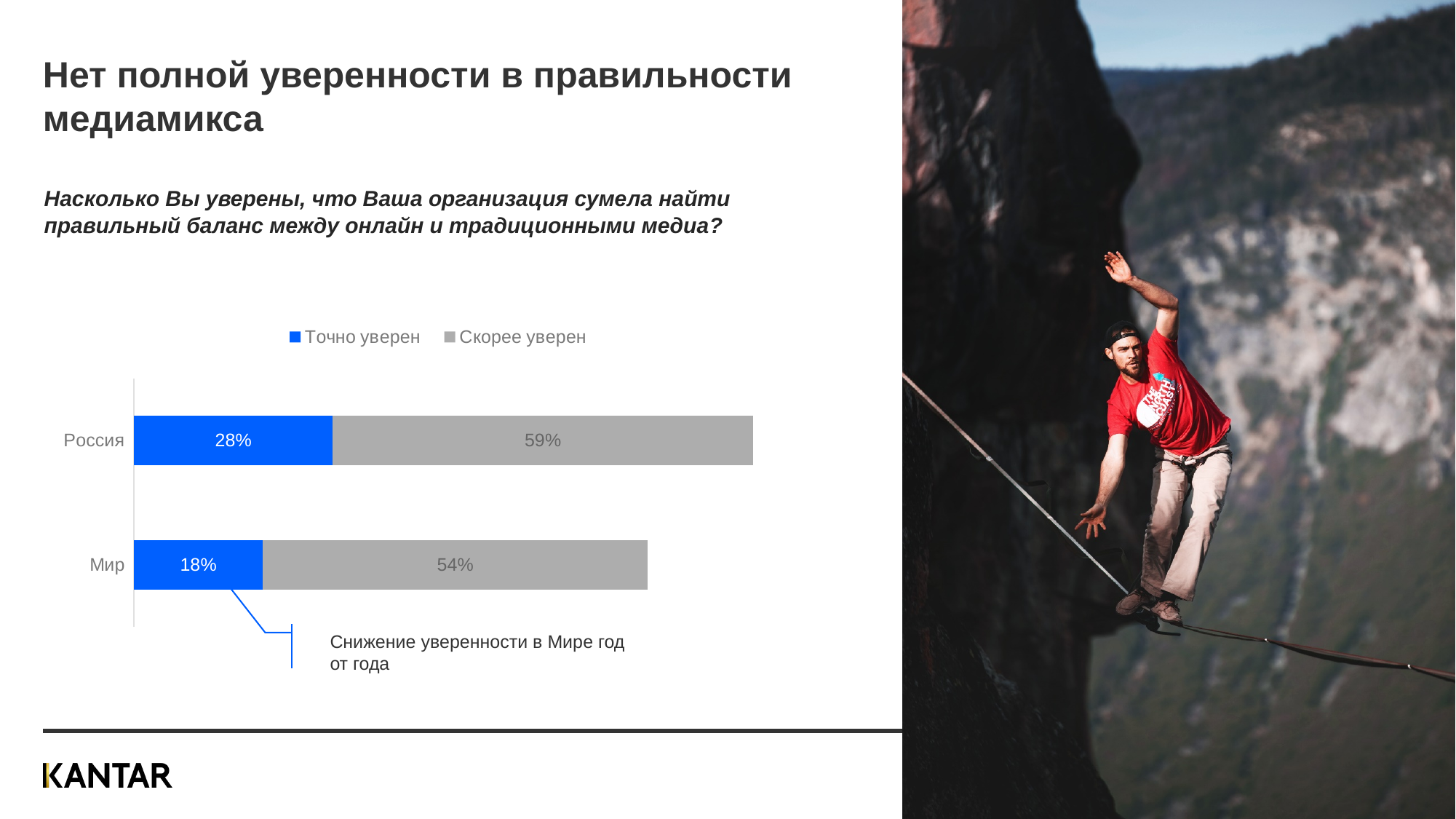
What is the difference between the "Скорее уверен" values for Россия and Мир? 5% What is the total of the stacked bar for Россия? 87% Which category has the higher "Точно уверен" value, Россия or Мир? Россия What type of chart is shown on the slide? Stacked bar chart What is the value of "Скорее уверен" for Россия? 59% What is the difference between the "Точно уверен" values for Россия and Мир? 10% How many categories are shown in the chart? 2 What is the value of "Точно уверен" for Россия? 28% How many series does the legend list? 2 What is the value of "Скорее уверен" for Мир? 54% What is the total of the stacked bar for Мир? 72% What is the value of "Точно уверен" for Мир? 18%